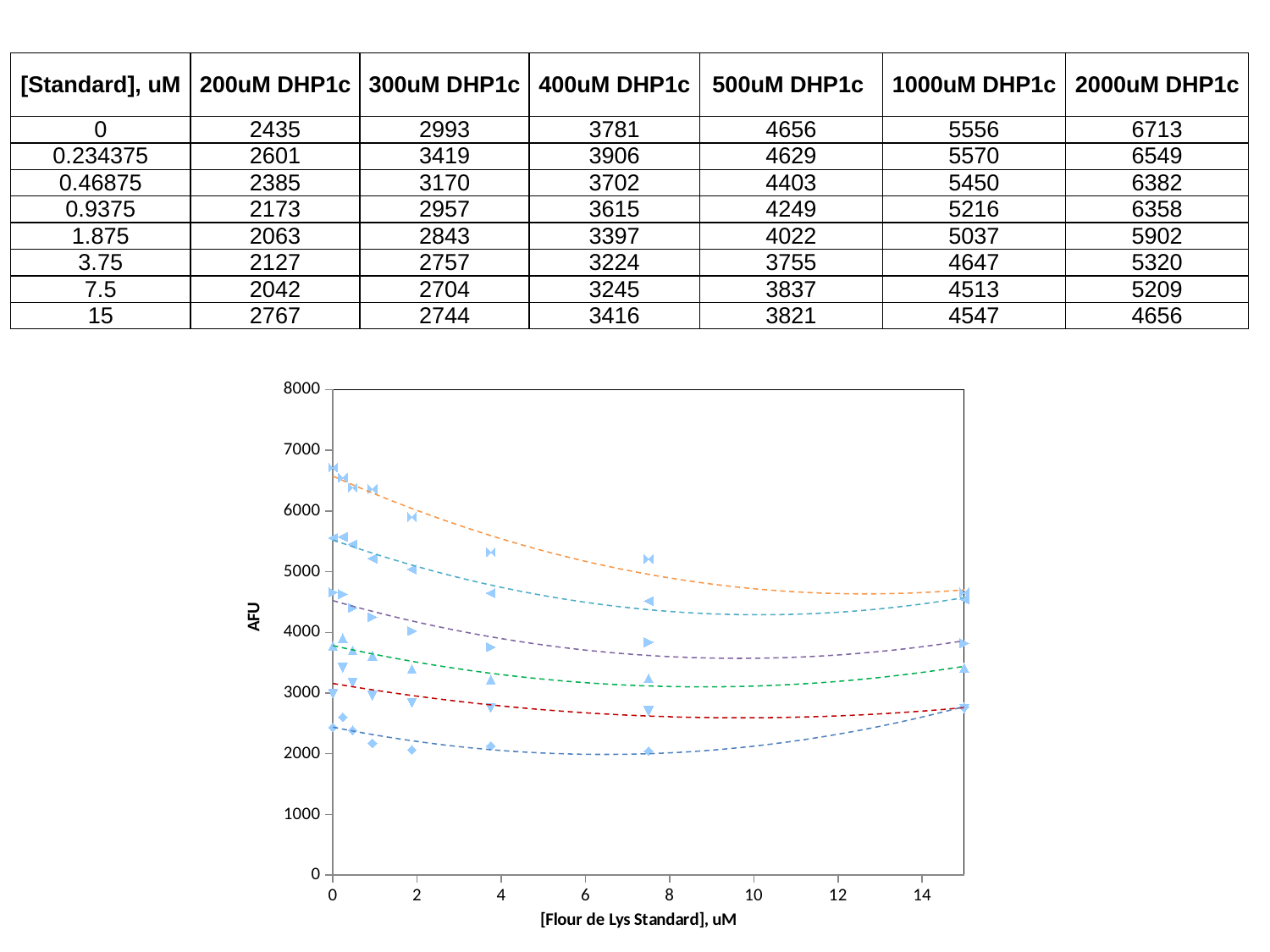
What is the label of the y axis of the chart? AFU How many standard concentrations (x values) are plotted for each series? 8 Which DHP1c concentration has the lowest AFU at 0 uM standard? 200uM DHP1c What kind of chart is shown on the slide? scatter chart At 0 uM standard, which is larger: the AFU for 500uM DHP1c or for 1000uM DHP1c? 1000uM DHP1c What is the AFU value for 500uM DHP1c at 3.75 uM standard? 3755 What is the label of the x axis of the chart? [Flour de Lys Standard], uM How many dashed trendline series are plotted on the chart? 6 Does the AFU for 2000uM DHP1c rise or fall as the standard concentration increases from 0 to 15 uM? fall Which DHP1c concentration has the highest AFU at 0 uM standard? 2000uM DHP1c What is the AFU value for 2000uM DHP1c at 0 uM standard? 6713 What is the difference between the AFU for 2000uM DHP1c at 0 uM standard and at 15 uM standard? 2057